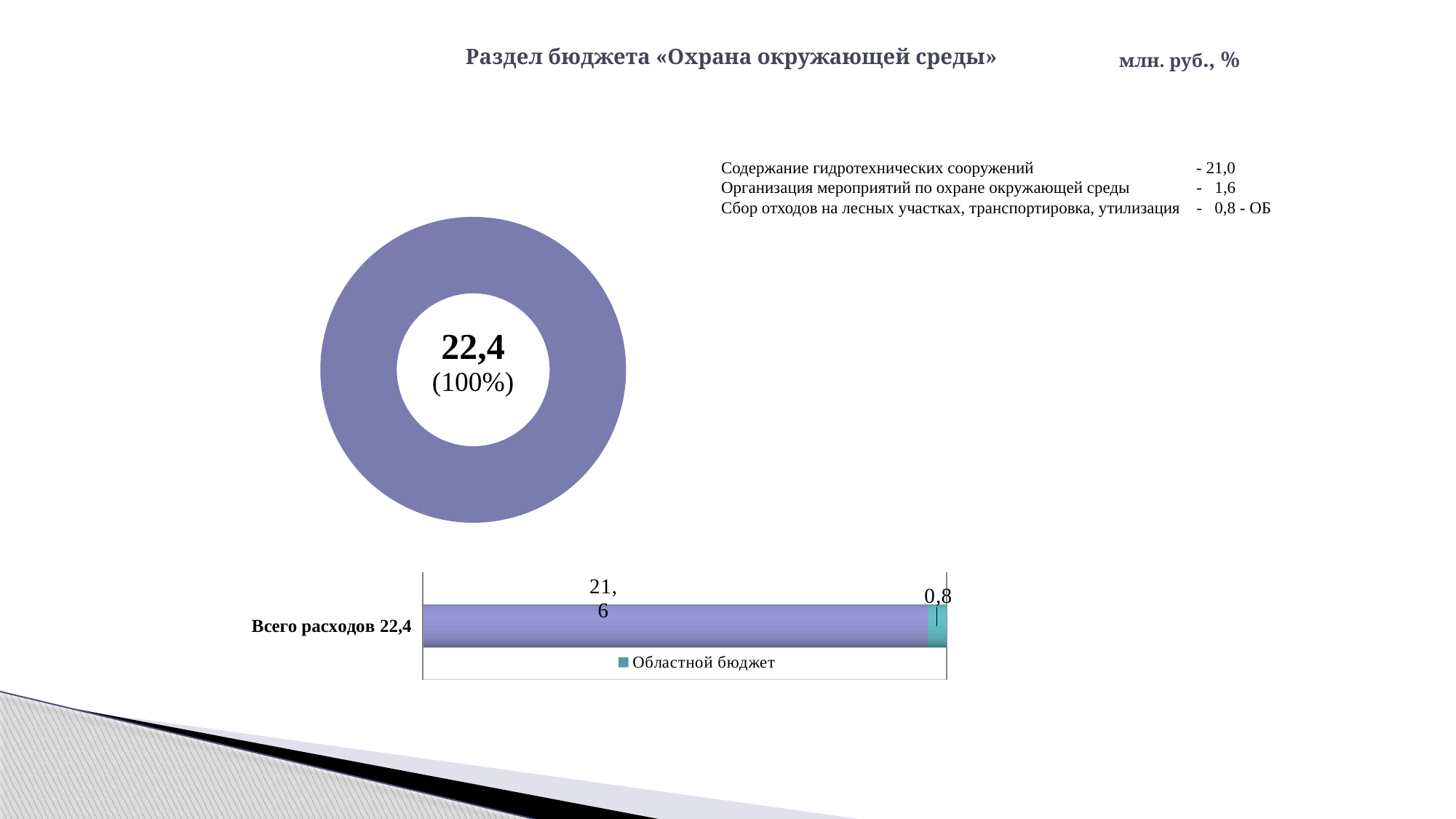
In the bottom bar chart, what entry does the legend show? Областной бюджет What share of the doughnut chart does the single slice represent? 100% What kind of chart is the chart at the bottom of the slide? bar chart In the bottom bar chart, what is the value of the larger (purple) segment of the bar? 21,6 In the bottom bar chart, what is the category label of the bar? Всего расходов 22,4 What kind of chart is the chart on the left of the slide? doughnut chart In the bottom bar chart, what is the value of the smaller (teal) segment of the bar? 0,8 How many slices does the doughnut chart have? 1 In the bottom bar chart, what is the total of the stacked bar? 22,4 What value is printed in the centre of the doughnut chart? 22,4 In the bottom bar chart, which segment is larger, the purple one or the teal one? the purple one (21,6) In the bottom bar chart, what is the difference between the two segments of the bar, 21,6 and 0,8? 20,8